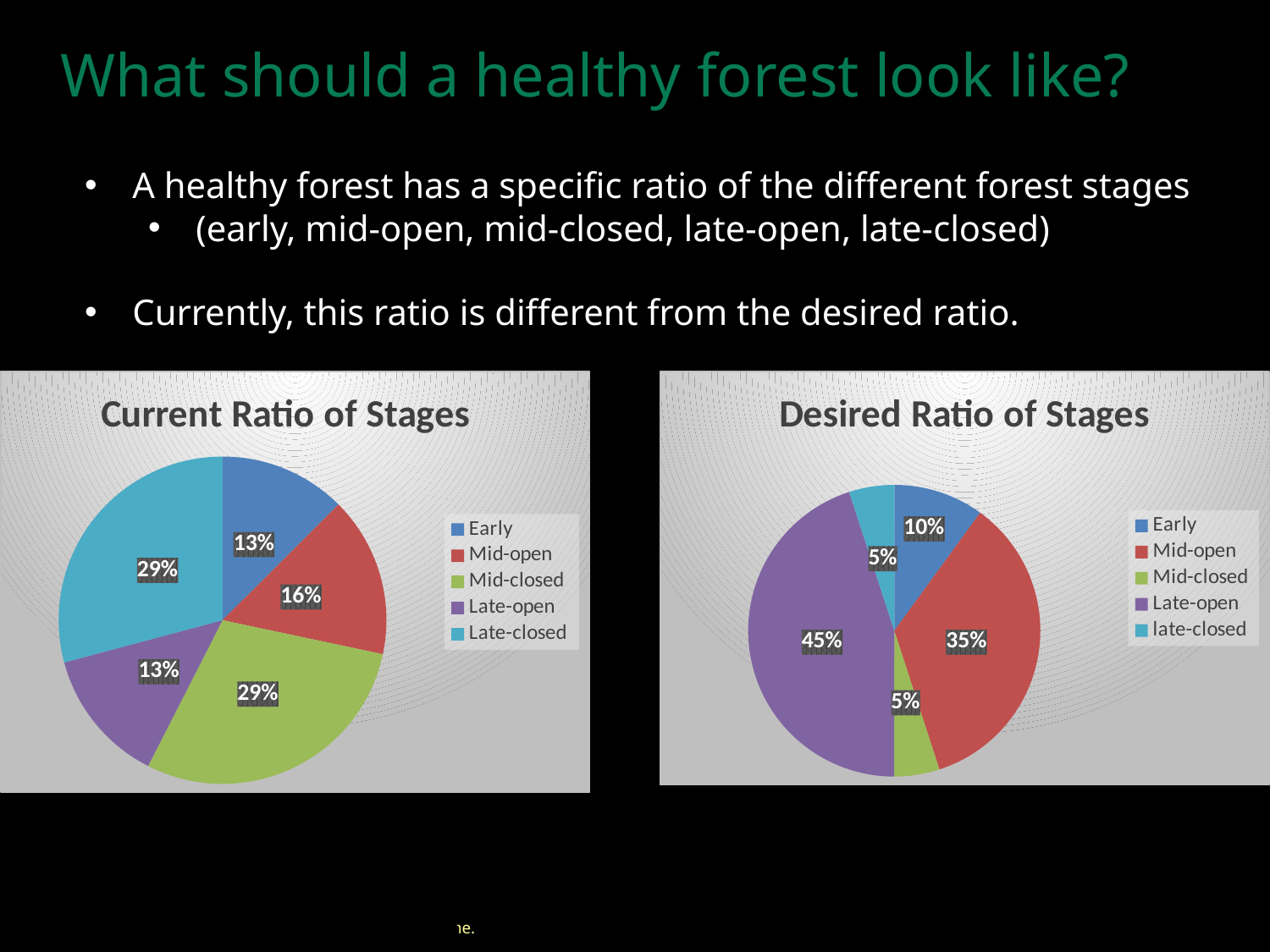
In the "Current Ratio of Stages" chart, what share does Mid-closed have? 29% In the "Current Ratio of Stages" chart, what is the difference between the Late-closed share and the Late-open share? 16% What type of chart is the "Desired Ratio of Stages" chart? Pie chart In the "Desired Ratio of Stages" chart, which is larger, Mid-open or Mid-closed? Mid-open In the "Current Ratio of Stages" chart, which is larger, Mid-open or Mid-closed? Mid-closed In the "Current Ratio of Stages" chart, what share does Mid-open have? 16% In the "Desired Ratio of Stages" chart, what share does Early have? 10% In the "Desired Ratio of Stages" chart, what is the difference between the Late-open share and the Mid-open share? 10% In the "Desired Ratio of Stages" chart, what share does Late-open have? 45% How many entries does the legend of the "Desired Ratio of Stages" chart list? 5 In the "Desired Ratio of Stages" chart, which stage has the largest share? Late-open How many slices does the "Current Ratio of Stages" chart have? 5